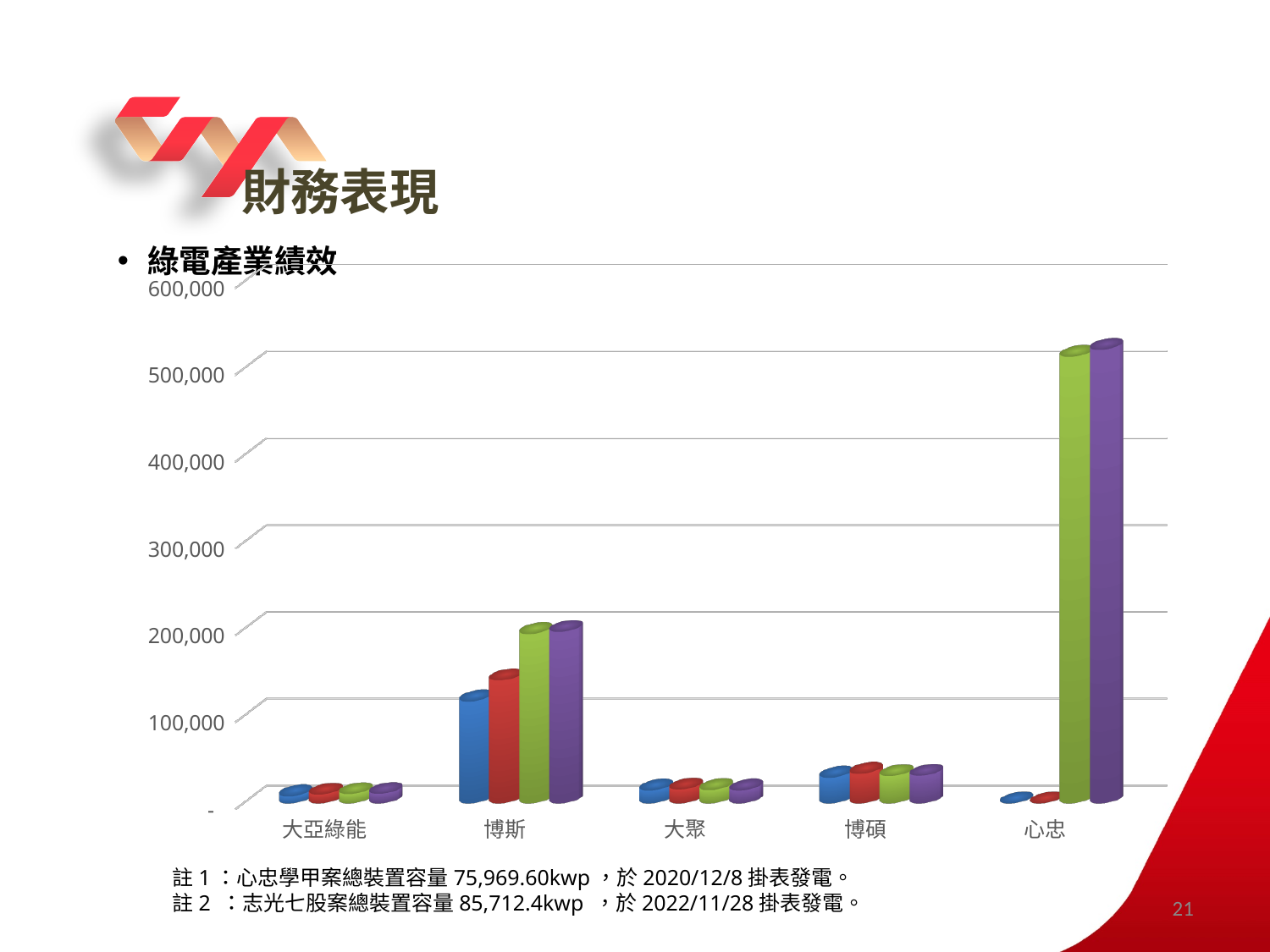
What is the highest value shown on the vertical axis of the chart? 600,000 Is the value of the blue bar for 博斯 greater or less than 100,000? greater Is the value of the tallest bar for 博碩 greater or less than 100,000? less Which category has the tallest bar in the chart? 心忠 What kind of chart is shown on the slide? bar chart Is the value of the tallest bar for 心忠 greater or less than 500,000? greater What is the label of the last category on the x axis of the chart? 心忠 How many categories are shown on the x axis of the chart? 5 Which category has taller bars overall, 博斯 or 博碩? 博斯 Which category has the taller purple bar, 心忠 or 博斯? 心忠